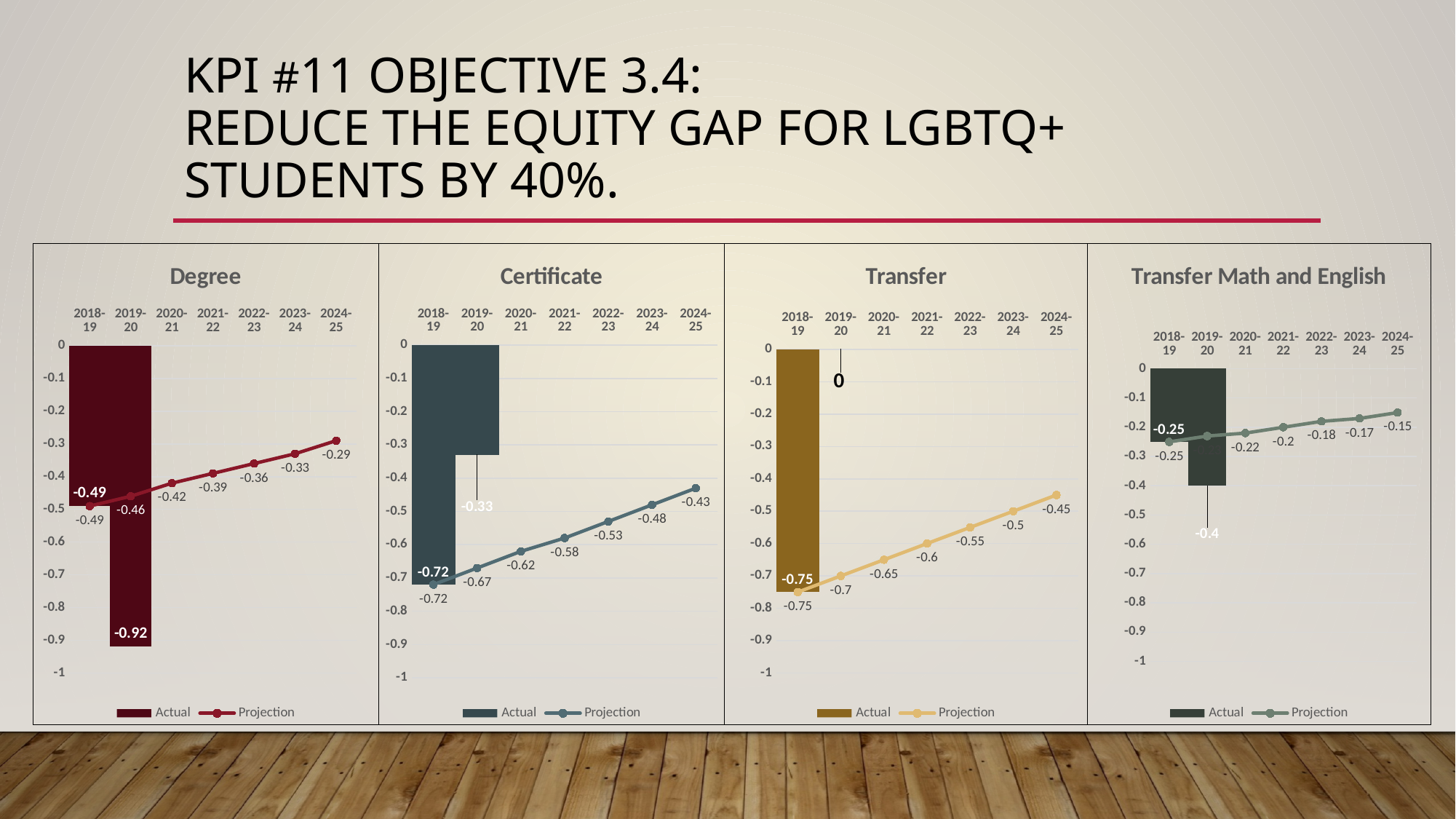
In the Transfer Math and English chart, which is larger, the Projection value for 2020-21 or for 2024-25? 2024-25 In the Transfer chart, what is the Actual value for 2019-20? 0 How many year categories are shown on the x axis of the Transfer chart? 7 In the Certificate chart, what is the Projection value for 2021-22? -0.58 In the Degree chart, what is the Actual value for 2019-20? -0.92 In the Certificate chart, does the Projection line rise or fall from 2018-19 to 2024-25? rise In the Transfer Math and English chart, what is the Actual value for 2019-20? -0.4 In the Degree chart, what is the Projection value for 2024-25? -0.29 How many series does the legend of the Degree chart list? 2 In the Transfer chart, which year has the lowest Projection value? 2018-19 In the Certificate chart, what is the Actual value for 2019-20? -0.33 In the Degree chart, what is the difference between the Actual values for 2018-19 and 2019-20? 0.43